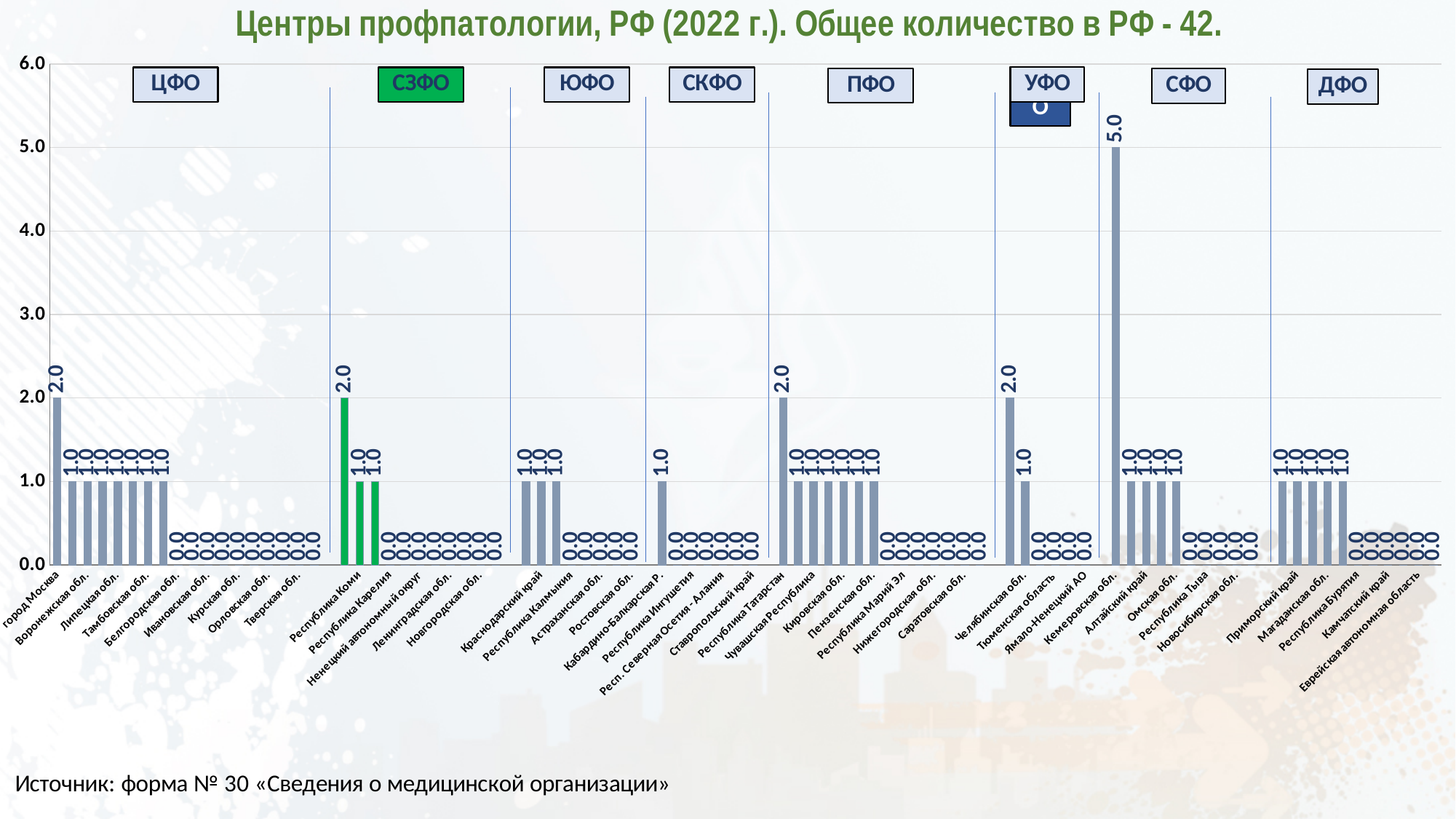
What is the value for Челябинская обл.? 1.0 According to the chart title, what is the total number of centres in the RF? 42 Which is larger, the value for Республика Татарстан or for Кабардино-Балкарская Р.? Республика Татарстан Which region has the highest value on the chart? Кемеровская обл. What is the difference between the values for Кемеровская обл. and город Москва? 3.0 How many federal district labels (ЦФО, СЗФО, etc.) are shown above the chart? 8 What kind of chart is shown on the slide? bar chart What is the value for город Москва? 2.0 Is the value for Кемеровская обл. greater or less than 4.0? greater How many bars are coloured green on the chart? 3 What is the value for Республика Коми? 1.0 What is the value for Кемеровская обл.? 5.0